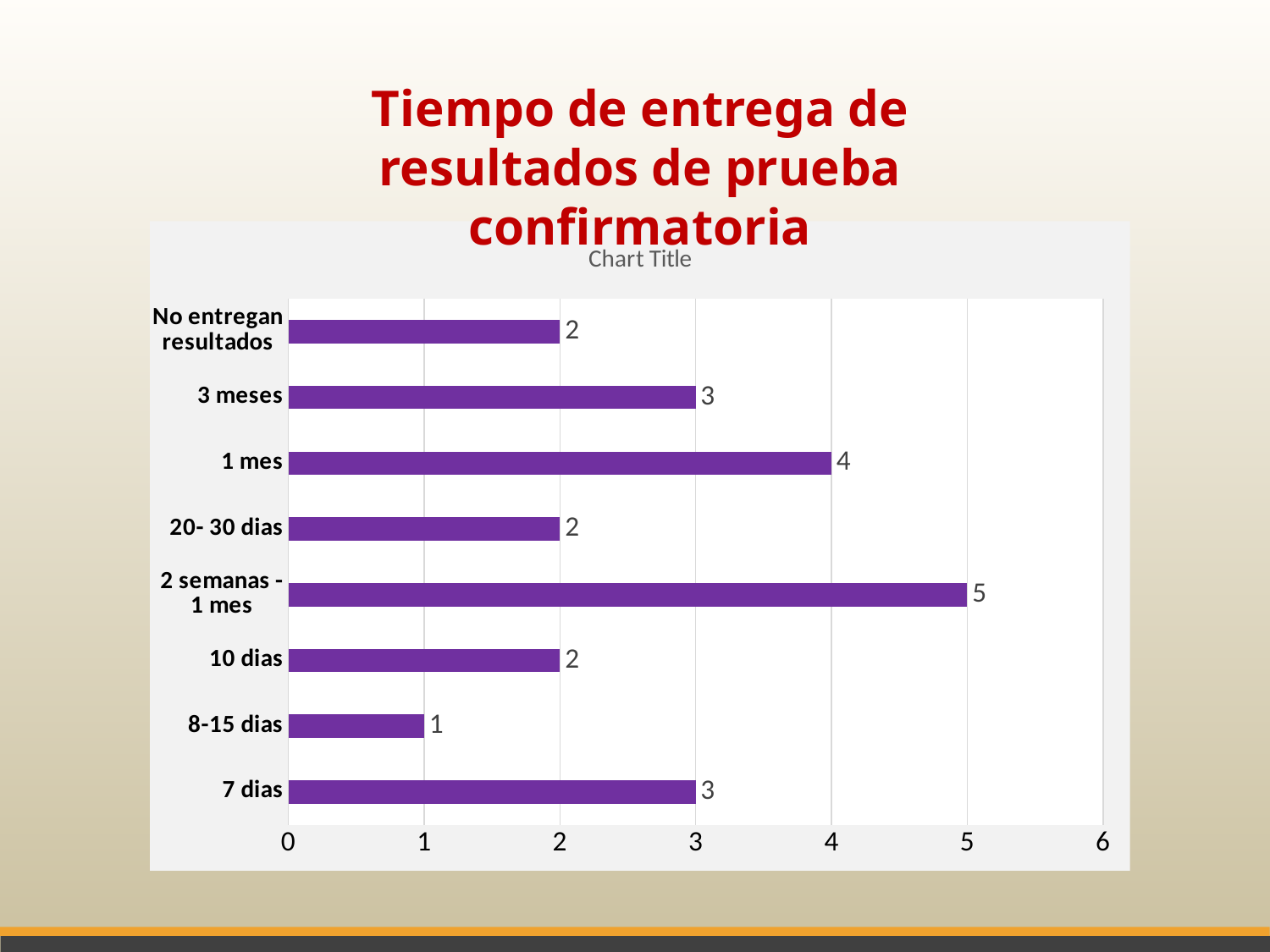
What is the difference between the values for "2 semanas - 1 mes" and "1 mes"? 1 What is the value for "1 mes"? 4 What is the title shown in red above the chart? Tiempo de entrega de resultados de prueba confirmatoria How many categories are shown in the chart? 8 What is the difference between the values for "3 meses" and "8-15 dias"? 2 What is the value for "8-15 dias"? 1 What kind of chart is shown on the slide? Bar chart What is the value for "No entregan resultados"? 2 Which category has the highest value? 2 semanas - 1 mes What is the value for "2 semanas - 1 mes"? 5 Which category has the lowest value? 8-15 dias Which is larger, the value for "7 dias" or the value for "10 dias"? 7 dias